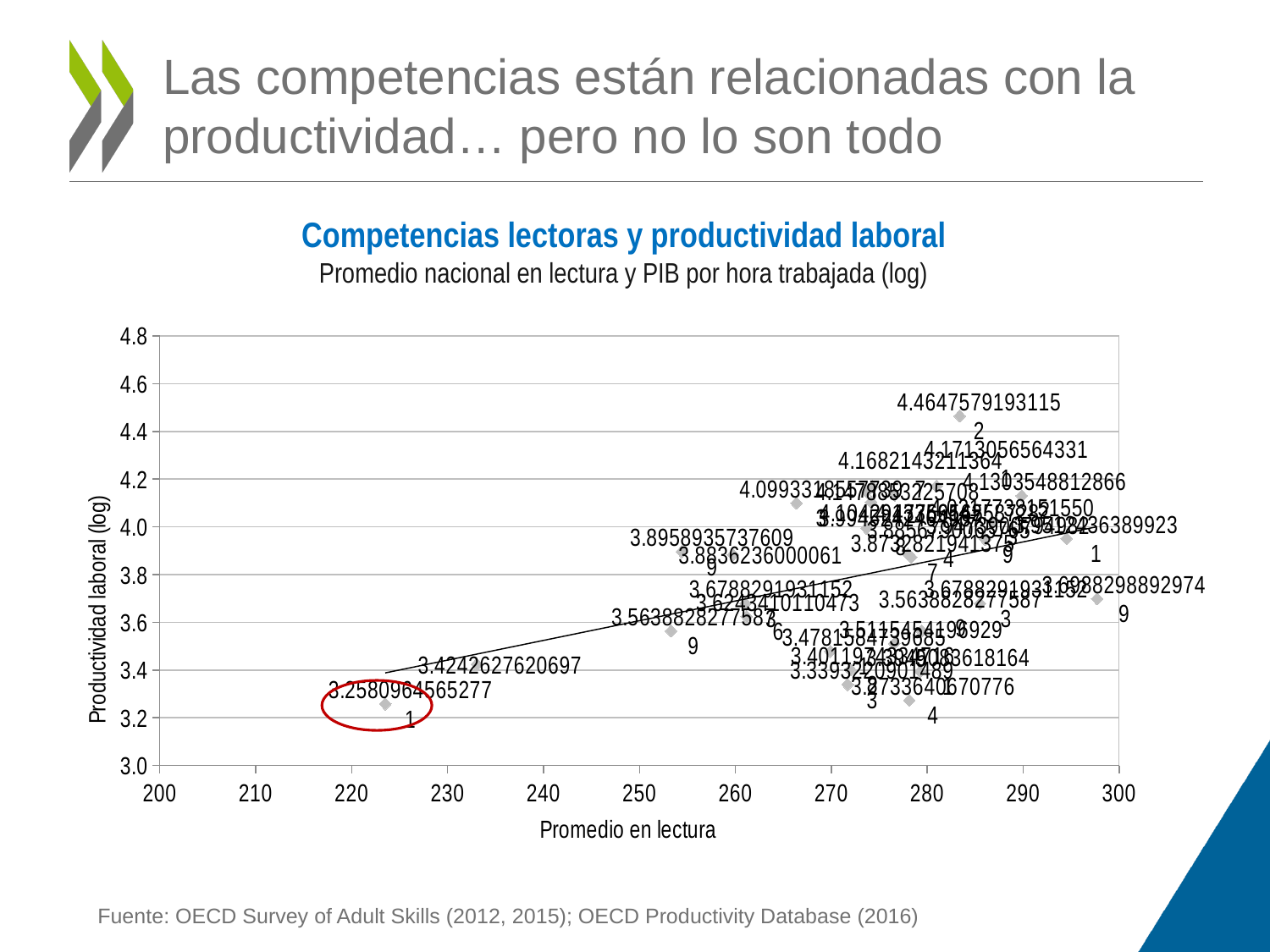
What is the title of the chart? Competencias lectoras y productividad laboral Is the productivity value of the circled point greater or less than 3.4? less What kind of chart is shown on the slide? Scatter chart Is the highest point on the chart greater or less than 4.4 on the vertical axis? greater What is the lowest productivity value plotted on the chart? 3.2580964565277 Does the trend line on the chart rise or fall as the reading average increases? Rises What is the highest productivity value plotted on the chart? 4.4647579193115 What is the difference between the highest and the lowest productivity values plotted on the chart? 1.2066614627838 What is the productivity value of the point circled in red on the chart? 3.2580964565277 Which is larger: the productivity value of the circled point or the value of the highest point, 4.4647579193115? 4.4647579193115 Is the reading score of the circled point greater or less than 230? less What is the label of the vertical axis of the chart? Productividad laboral (log)